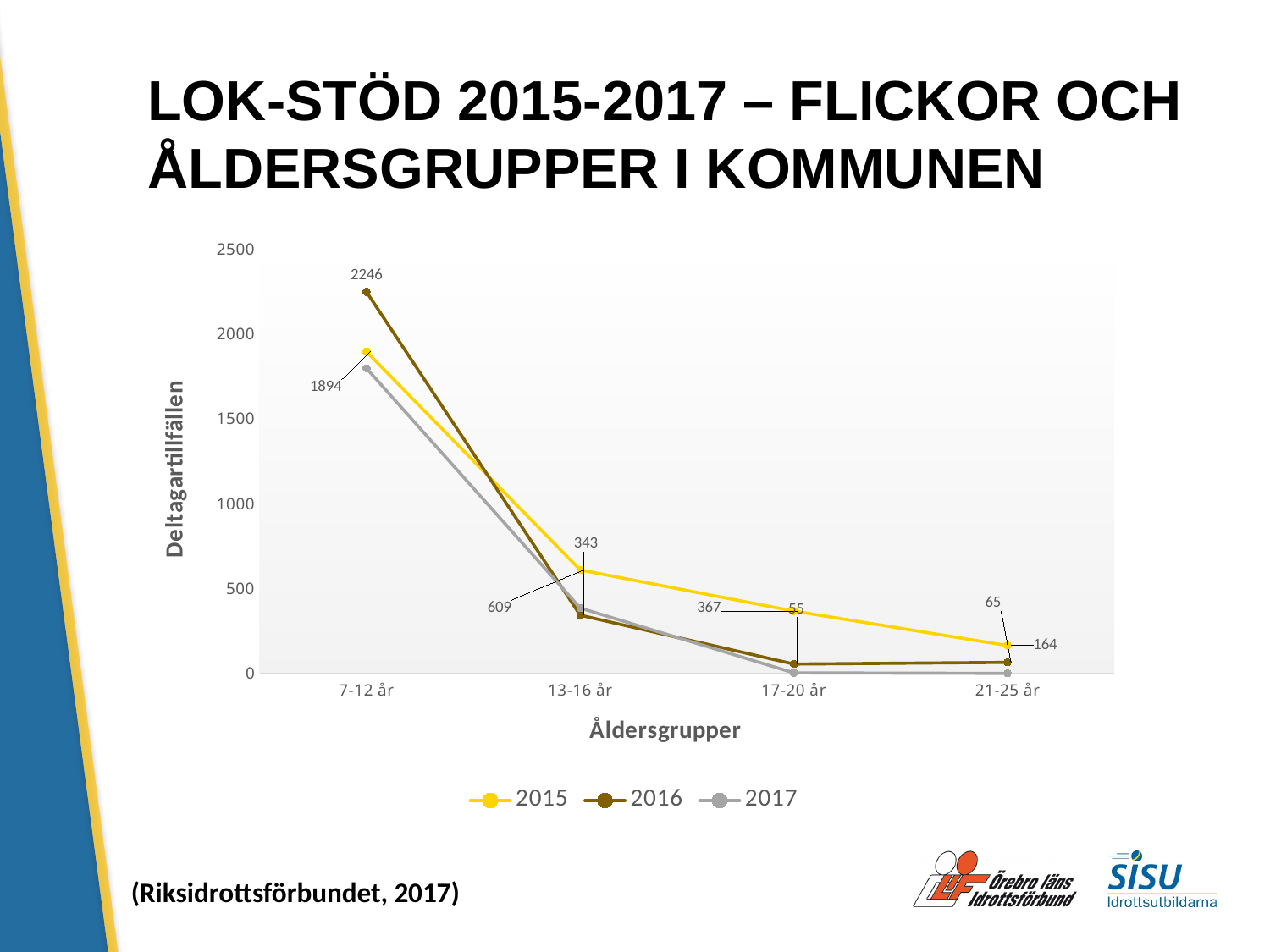
Which age group has the highest value for the 2016 series? 7-12 år What is the value for 2016 in the 7-12 år age group? 2246 What is the value for 2015 in the 13-16 år age group? 609 What kind of chart is shown on the slide? Line chart What is the difference between the 2015 and 2016 values in the 13-16 år age group? 266 What is the value for 2015 in the 21-25 år age group? 164 How many age groups are shown on the x axis? 4 Is the value for 2017 in the 7-12 år age group greater or less than 1500? greater How many series does the legend list? 3 What is the value for 2016 in the 13-16 år age group? 343 What is the value for 2016 in the 17-20 år age group? 55 What is the value for 2015 in the 17-20 år age group? 367